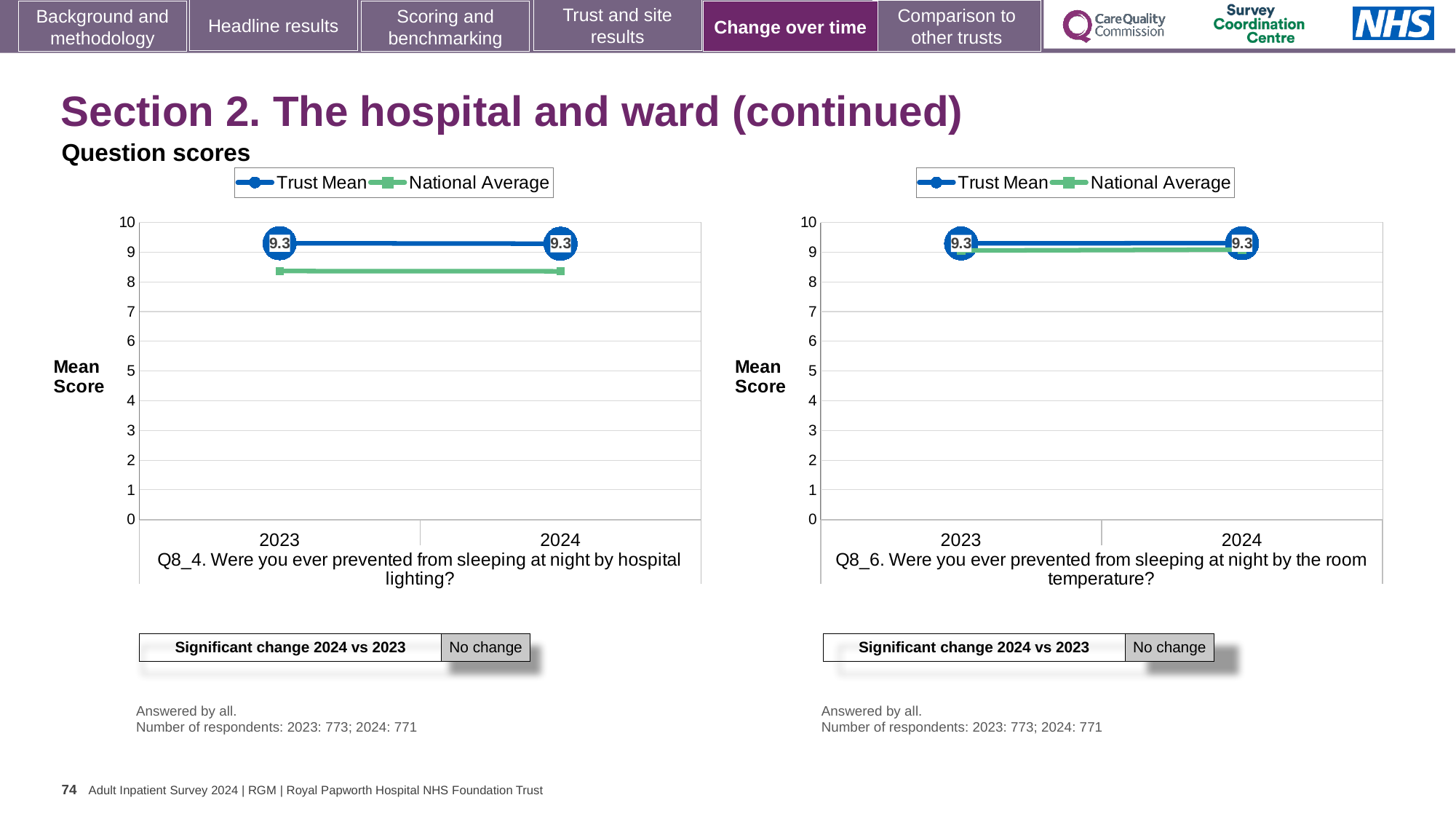
In the left chart (Q8_4, hospital lighting), what is the Trust Mean score for 2024? 9.3 In the left chart (Q8_4, hospital lighting), does the Trust Mean rise, fall or stay the same from 2023 to 2024? Stays the same How many series does the legend of the right chart (Q8_6, room temperature) list? 2 In the right chart (Q8_6, room temperature), what is the Trust Mean score for 2024? 9.3 What kind of chart is the left chart (Q8_4, hospital lighting)? Line chart What does the 'Significant change 2024 vs 2023' box under the right chart (Q8_6, room temperature) say? No change In the right chart (Q8_6, room temperature), what is the Trust Mean score for 2023? 9.3 In the left chart (Q8_4, hospital lighting), which is higher in 2024, the Trust Mean or the National Average? Trust Mean In the left chart (Q8_4, hospital lighting), is the National Average for 2023 greater or less than 9? less In the right chart (Q8_6, room temperature), what is the difference between the Trust Mean in 2024 and in 2023? 0 How many years are shown on the x axis of the left chart (Q8_4, hospital lighting)? 2 In the left chart (Q8_4, hospital lighting), what is the Trust Mean score for 2023? 9.3